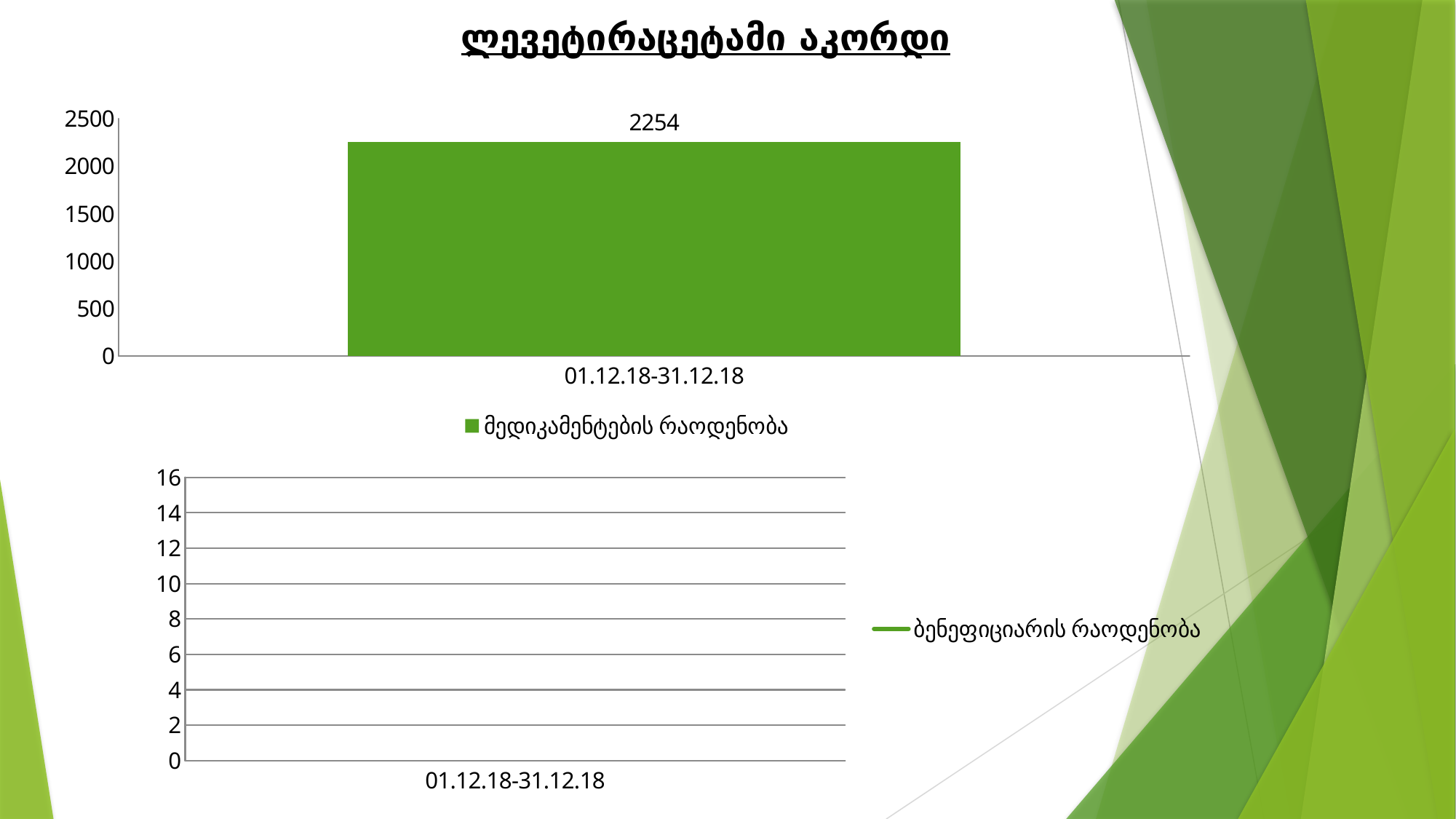
What kind of chart is the top chart? bar chart How many series does the legend of the bottom chart list? 1 In the top chart, is the value for 01.12.18-31.12.18 greater or less than 2500? less How many series does the legend of the top chart list? 1 What is the legend entry of the bottom chart? ბენეფიციარის რაოდენობა In the top chart, what is the value for 01.12.18-31.12.18? 2254 What is the legend entry of the top chart? მედიკამენტების რაოდენობა In the top chart, is the value for 01.12.18-31.12.18 greater or less than 2000? greater How many categories are shown on the x axis of the top chart? 1 What category label is shown on the x axis of the bottom chart? 01.12.18-31.12.18 What is the highest tick value on the y axis of the bottom chart? 16